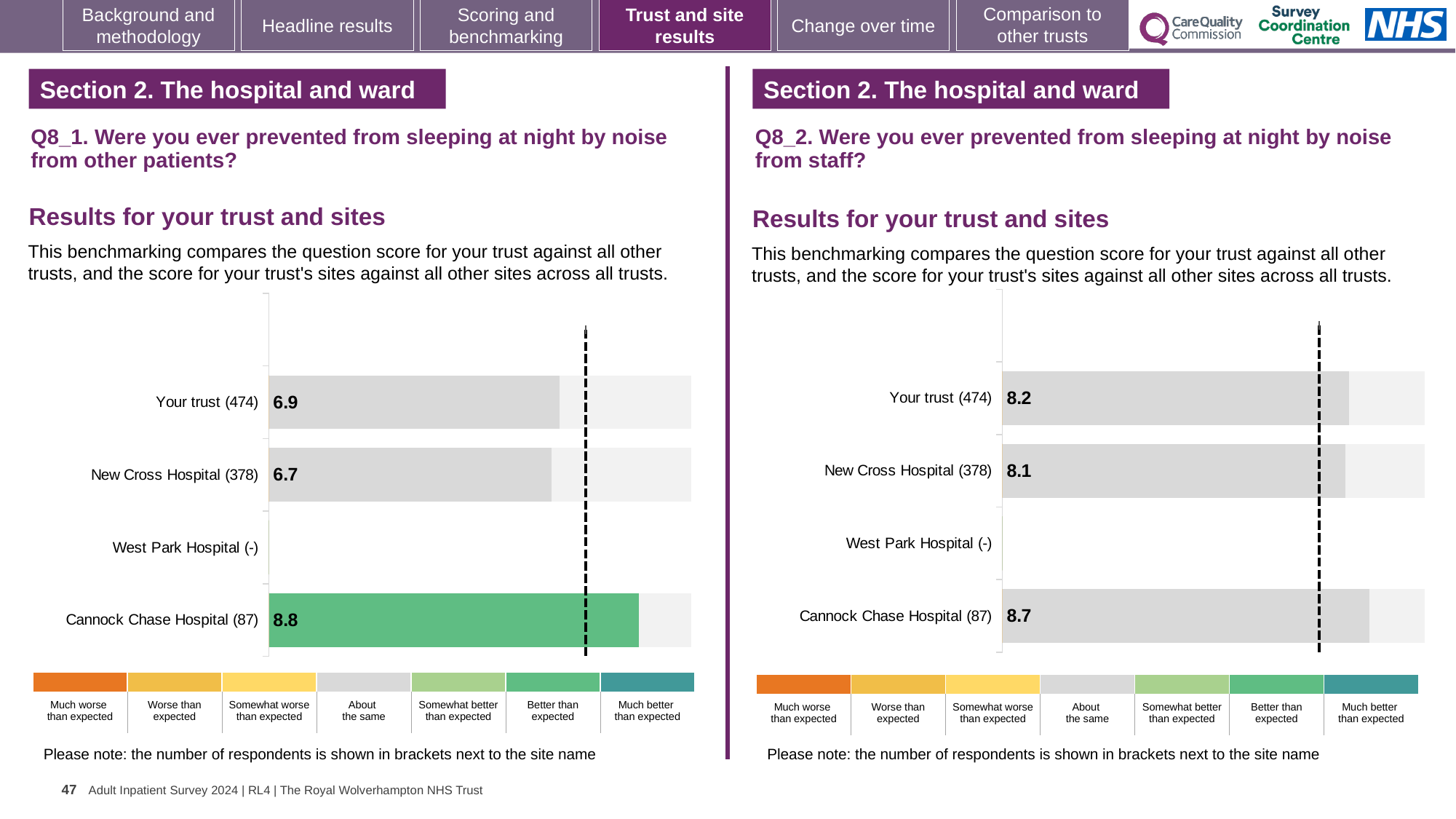
On the Q8_2 chart (right), what is the score for New Cross Hospital (378)? 8.1 On the Q8_1 chart (left), which bar is shown in green rather than grey? Cannock Chase Hospital (87) On the Q8_1 chart (left), what is the score for Cannock Chase Hospital (87)? 8.8 On the Q8_2 chart (right), which site or trust has the lowest score among those with a value shown? New Cross Hospital (378) On the Q8_1 chart (left), which site or trust has the highest score? Cannock Chase Hospital (87) What kind of chart is the Q8_2 chart (right)? bar chart On the Q8_2 chart (right), what is the score for Cannock Chase Hospital (87)? 8.7 How many categories are listed on the y axis of the Q8_1 chart (left)? 4 On the Q8_1 chart (left), what is the difference between the scores for Cannock Chase Hospital (87) and New Cross Hospital (378)? 2.1 On the Q8_2 chart (right), is the score for Your trust (474) larger or smaller than the score for Cannock Chase Hospital (87)? smaller On the Q8_2 chart (right), what is the difference between the scores for Your trust (474) and New Cross Hospital (378)? 0.1 On the Q8_1 chart (left), what is the score for Your trust (474)? 6.9